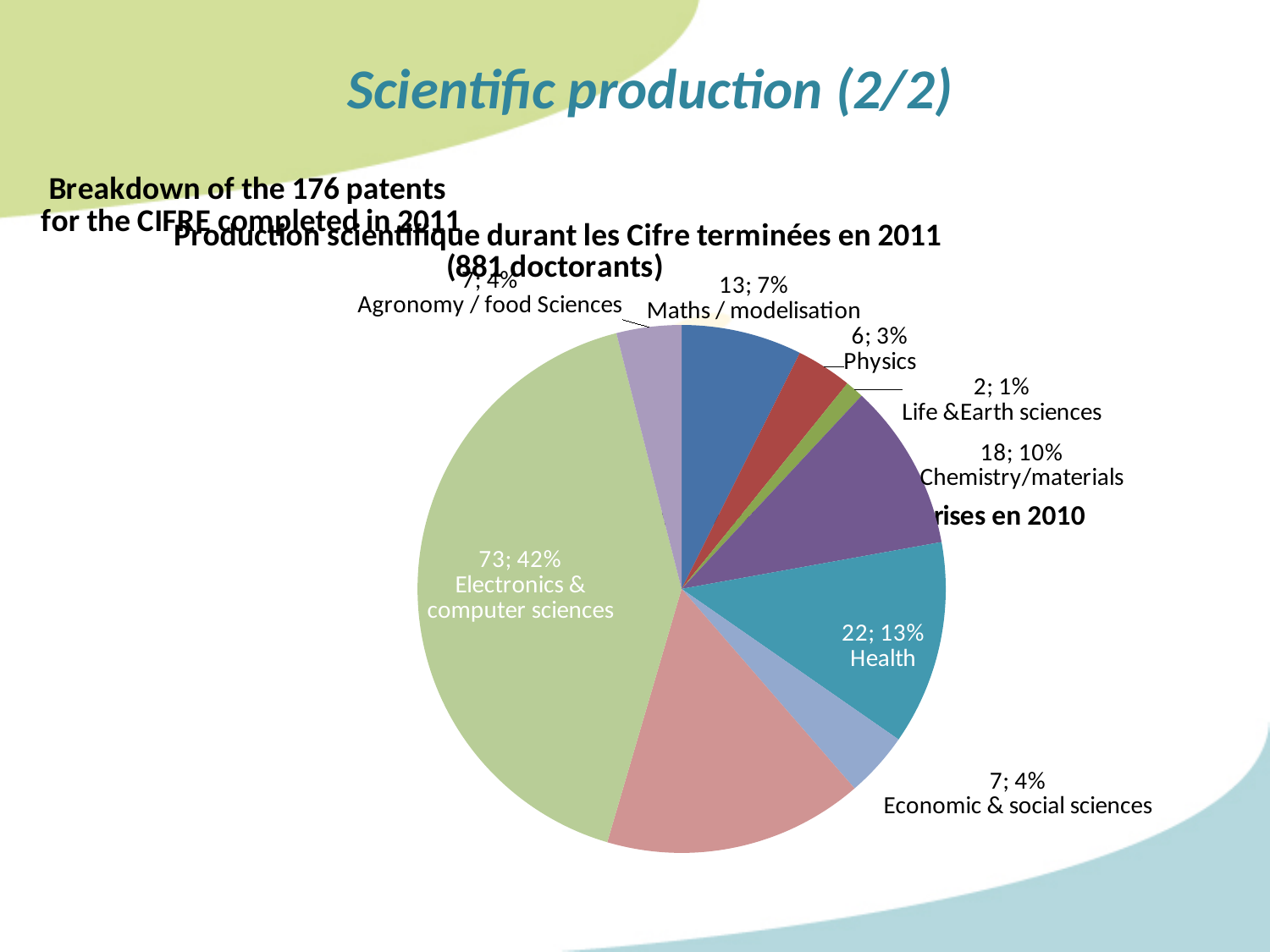
Which labelled category has the largest slice of the pie? Electronics & computer sciences Which labelled category has the smallest slice of the pie? Life & Earth sciences How many patents are attributed to Chemistry/materials? 18 What is the difference in the number of patents between Health and Chemistry/materials? 4 What share of the pie does Maths / modelisation represent? 7% What share of the pie does Electronics & computer sciences represent? 42% What kind of chart is shown on the slide? pie chart What is the difference in the number of patents between Electronics & computer sciences and Health? 51 How many patents are attributed to Economic & social sciences? 7 What share of the pie does Physics represent? 3% Which has more patents, Physics or Maths / modelisation? Maths / modelisation How many patents are attributed to Health in the pie chart? 22